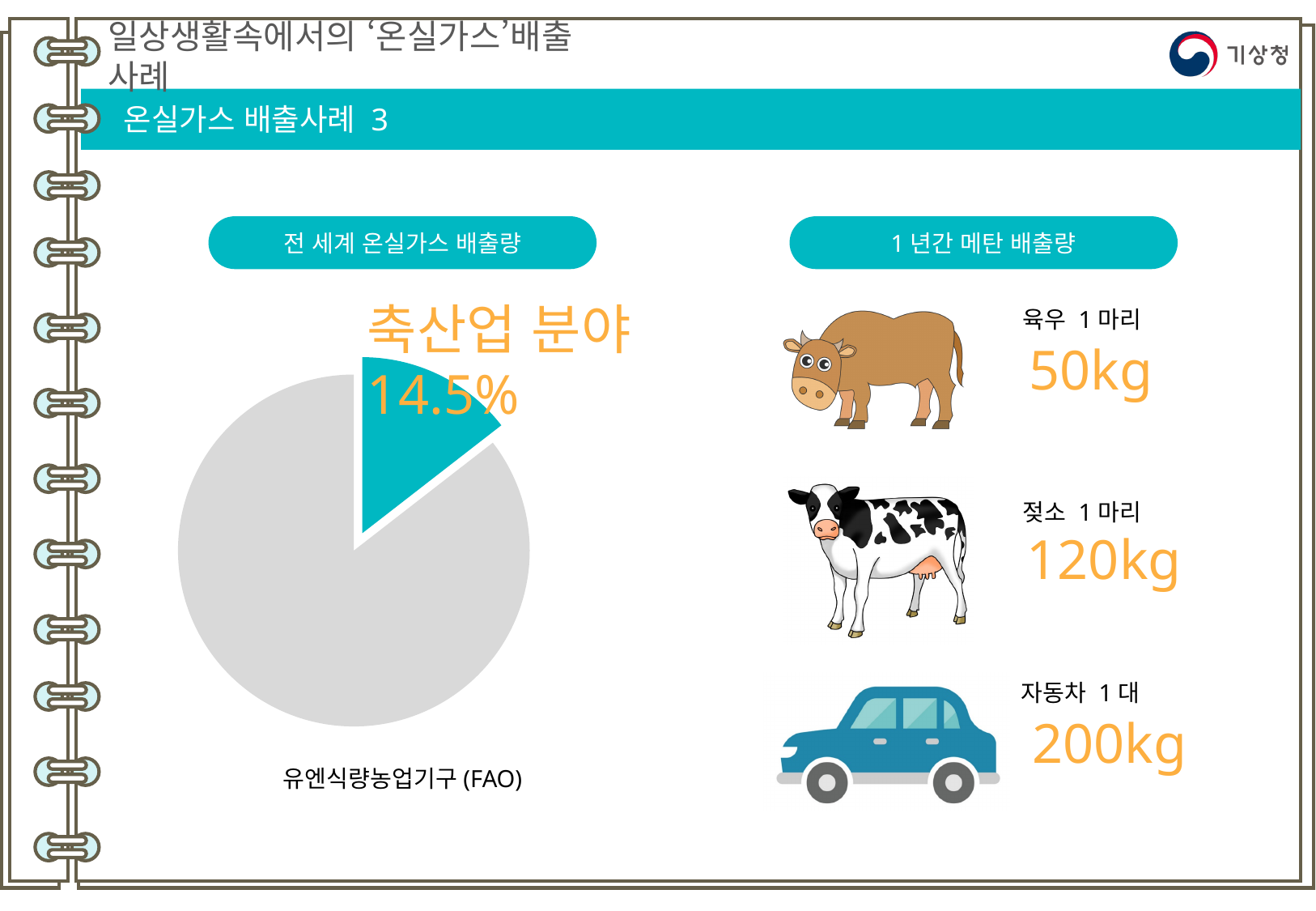
In the right-hand panel titled '1 년간 메탄 배출량', which item has the lowest value? 육우 1 마리 In the right-hand panel titled '1 년간 메탄 배출량', what is the difference between the values for 젖소 1 마리 and 육우 1 마리? 70kg In the right-hand panel titled '1 년간 메탄 배출량', which item has the highest value? 자동차 1 대 How many slices does the pie chart on the left have? 2 In the right-hand panel titled '1 년간 메탄 배출량', what is the value for 자동차 1 대? 200kg In the right-hand panel titled '1 년간 메탄 배출량', what is the value for 젖소 1 마리? 120kg What colour is the 축산업 분야 slice in the pie chart on the left? teal What source is cited below the pie chart on the left? 유엔식량농업기구 (FAO) What kind of chart is shown on the left side of the slide under '전 세계 온실가스 배출량'? pie chart In the pie chart on the left, is the 축산업 분야 slice larger or smaller than the remaining grey portion? smaller In the pie chart titled '전 세계 온실가스 배출량', what share is labelled for 축산업 분야? 14.5% In the right-hand panel titled '1 년간 메탄 배출량', what is the value for 육우 1 마리? 50kg